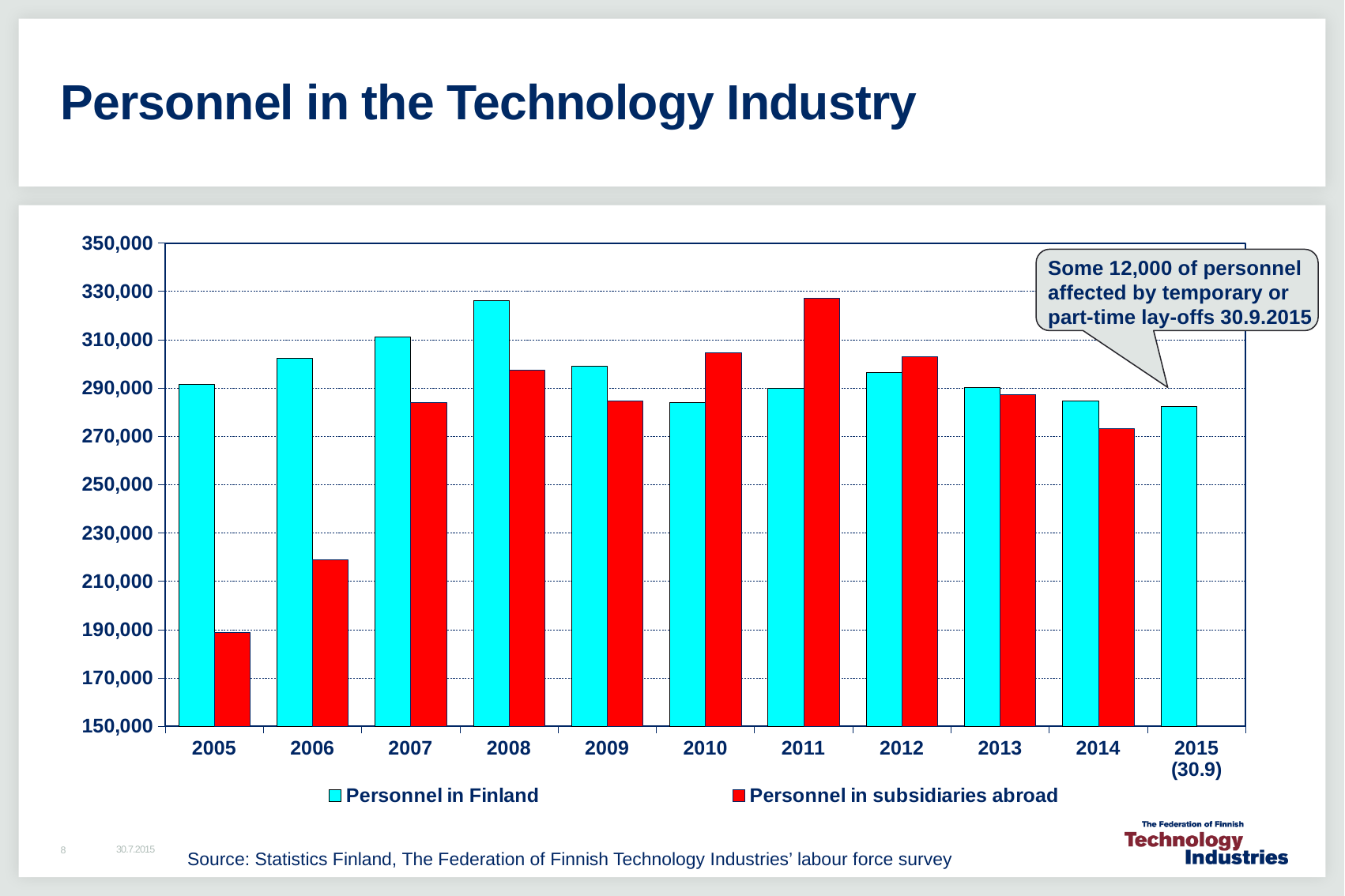
In which year is Personnel in subsidiaries abroad highest? 2011 What kind of chart is shown on the slide? bar chart How many series does the legend list? 2 In which year is Personnel in subsidiaries abroad lowest? 2005 In 2005, which is larger: Personnel in Finland or Personnel in subsidiaries abroad? Personnel in Finland Is the value for Personnel in subsidiaries abroad in 2006 greater or less than 210,000? greater In 2011, which is larger: Personnel in Finland or Personnel in subsidiaries abroad? Personnel in subsidiaries abroad Does Personnel in subsidiaries abroad rise or fall from 2005 to 2008? rise Is the value for Personnel in Finland in 2008 greater or less than 310,000? greater How many years (categories) are shown on the x axis? 11 Is the value for Personnel in subsidiaries abroad in 2014 greater or less than 290,000? less In which year is Personnel in Finland highest? 2008